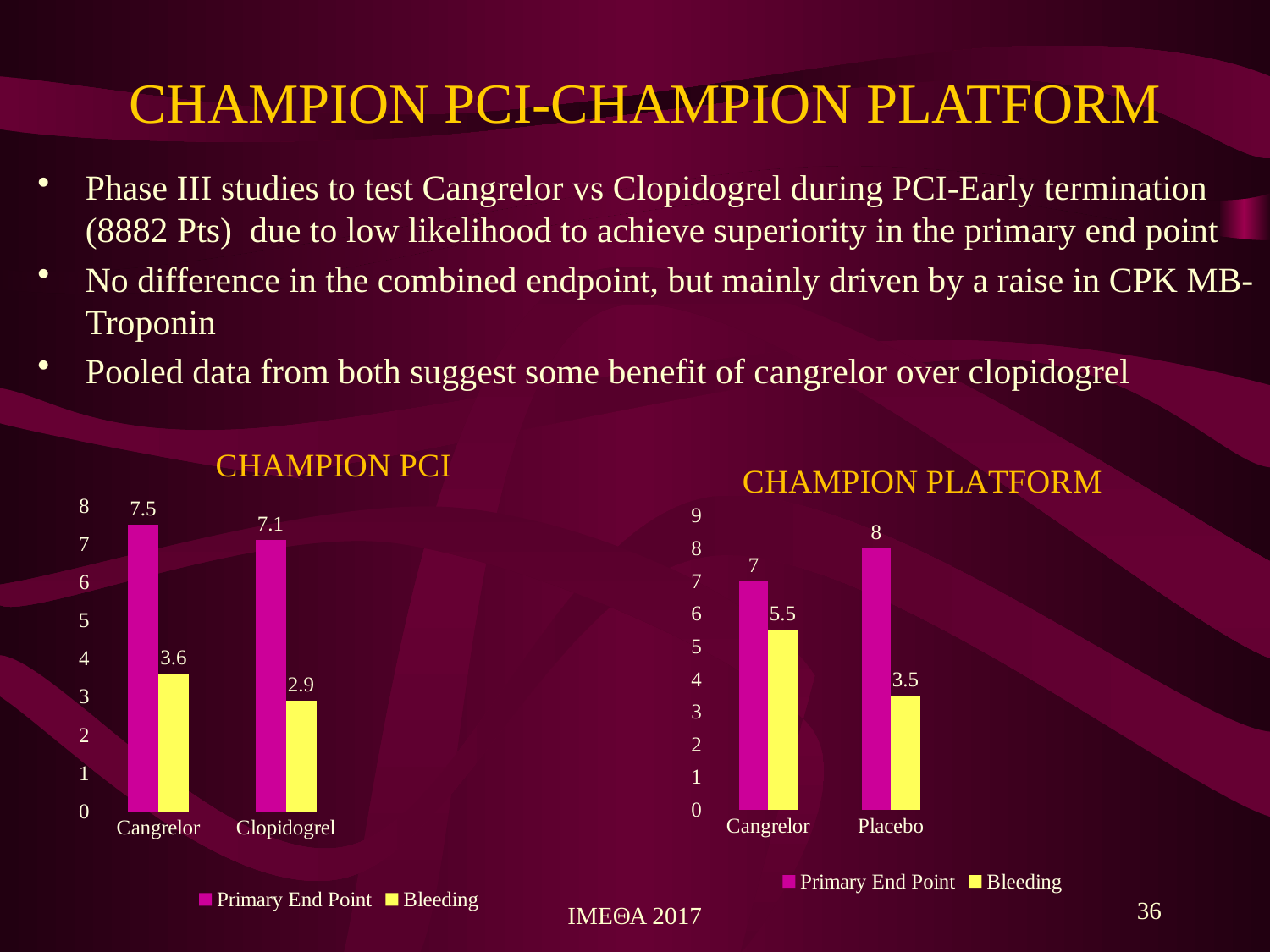
In the CHAMPION PCI chart, which colour represents the Bleeding series? Yellow In the CHAMPION PCI chart, what is the difference between the Bleeding values for Cangrelor and Clopidogrel? 0.7 In the CHAMPION PLATFORM chart, what is the difference between the Bleeding values for Cangrelor and Placebo? 2 What kind of chart is the CHAMPION PLATFORM chart? Bar chart In the CHAMPION PCI chart, what is the Primary End Point value for Cangrelor? 7.5 In the CHAMPION PLATFORM chart, what is the Primary End Point value for Placebo? 8 How many categories are shown on the x axis of the CHAMPION PLATFORM chart? 2 How many series does the legend of the CHAMPION PCI chart list? 2 In the CHAMPION PCI chart, which category has the lowest Bleeding value? Clopidogrel In the CHAMPION PCI chart, what is the Bleeding value for Clopidogrel? 2.9 In the CHAMPION PLATFORM chart, which category has the higher Primary End Point value, Cangrelor or Placebo? Placebo In the CHAMPION PLATFORM chart, what is the Bleeding value for Cangrelor? 5.5